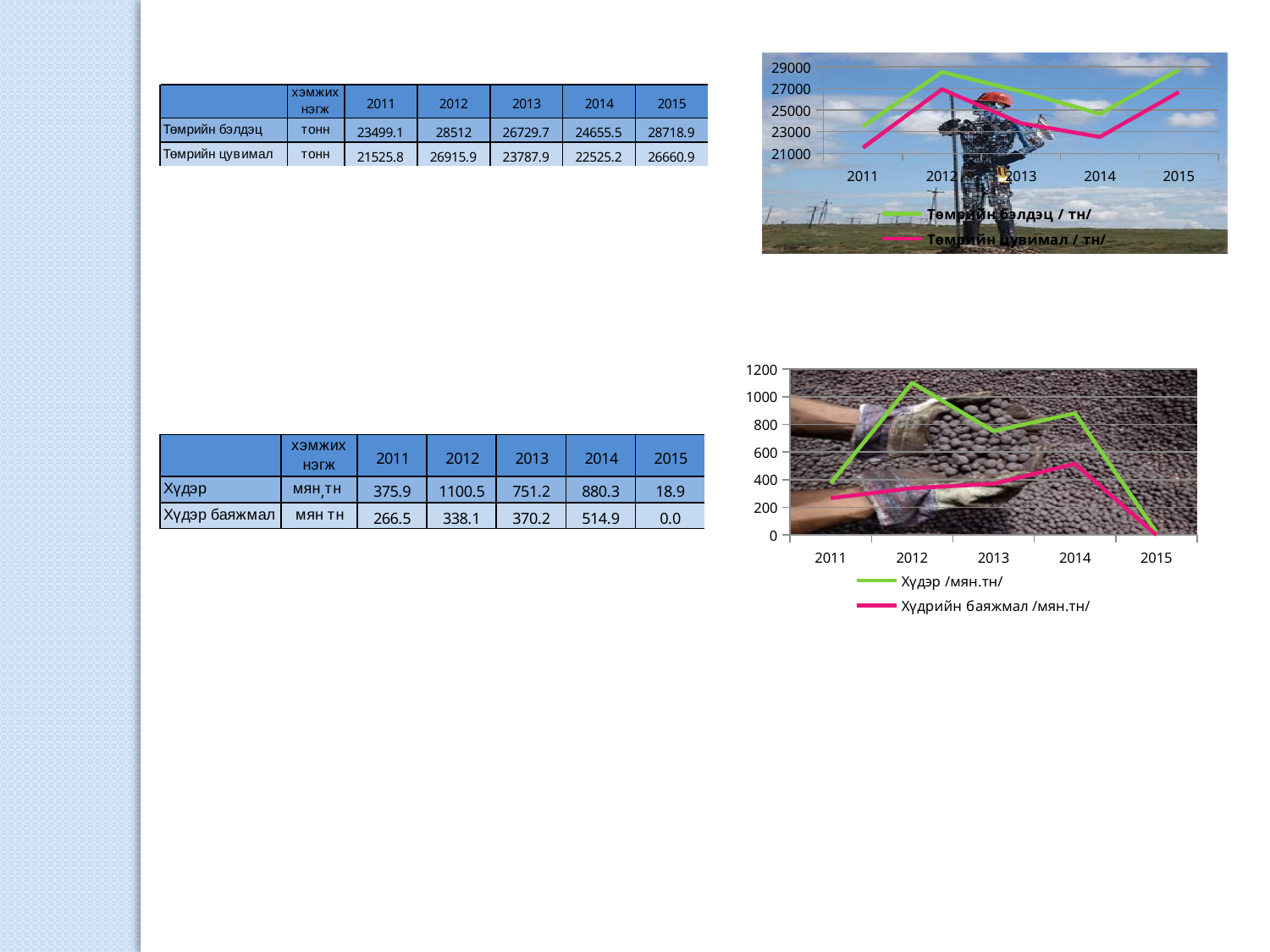
How many years are plotted along the x axis of the bottom-right chart? 5 In the top-right chart, is the value for Төмрийн цувимал / тн/ in 2011 greater or less than 23000? less Using the table values for the bottom-right chart, what is the difference between Хүдэр and Хүдэр баяжмал in 2014? 365.4 In the top-right chart, which series has the larger value in 2013, Төмрийн бэлдэц / тн/ or Төмрийн цувимал / тн/? Төмрийн бэлдэц / тн/ In the bottom-right chart, in which year is Хүдэр /мян.тн/ highest? 2012 In the top-right chart, is the value for Төмрийн бэлдэц / тн/ in 2012 greater or less than 27000? greater In the bottom-right chart, in which year is Хүдэр /мян.тн/ lowest? 2015 What colour is the line for Хүдэр /мян.тн/ in the bottom-right chart? green How many series does the legend of the top-right chart list? 2 What kind of chart is the top-right chart on the slide? line chart According to the table for the bottom-right chart, what is the value of Хүдэр in 2014? 880.3 In the bottom-right chart, does Хүдрийн баяжмал /мян.тн/ rise or fall from 2011 to 2014? rise